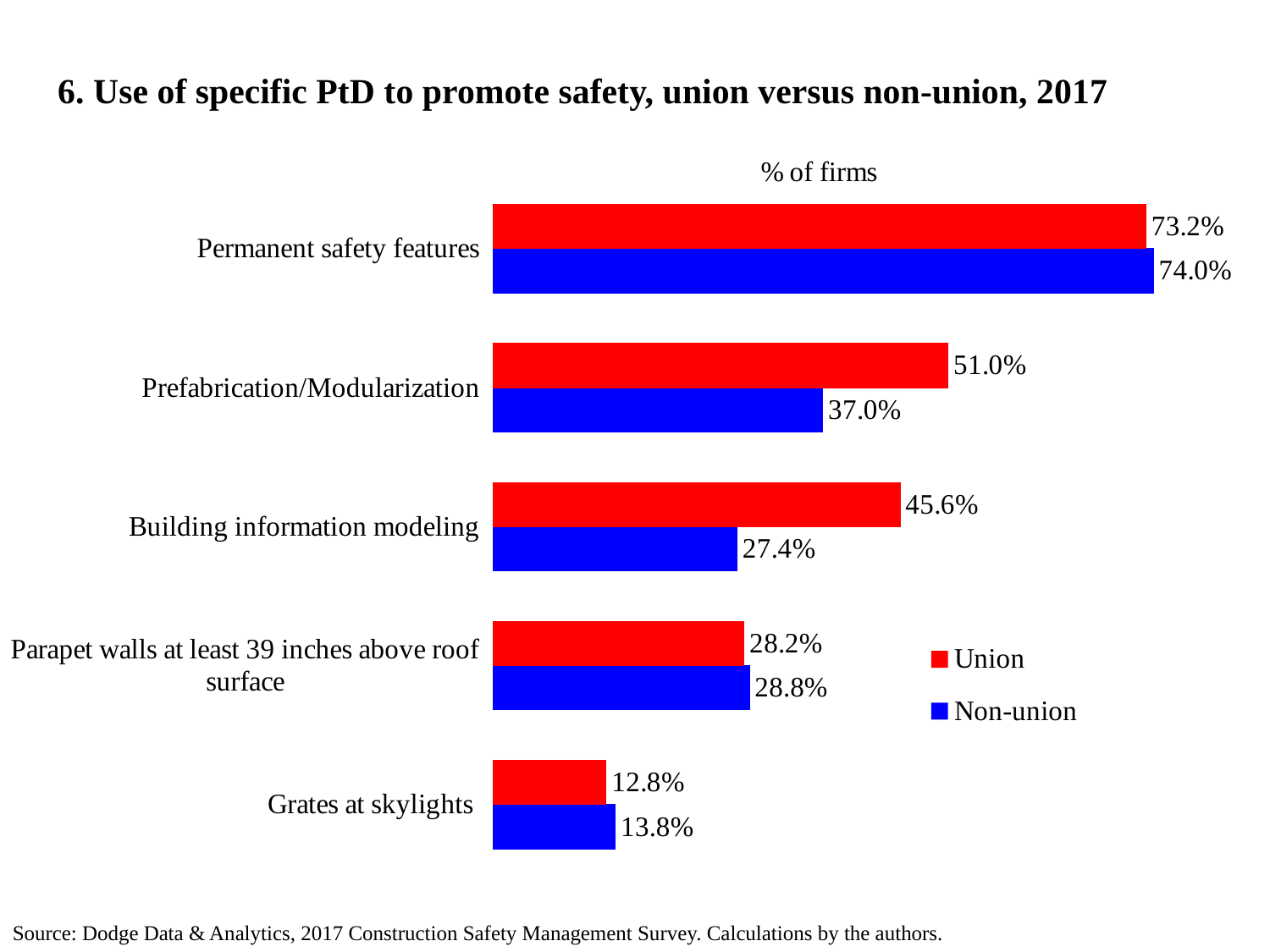
Which colour represents union firms in the chart? Red Which PtD category has the lowest value for non-union firms? Grates at skylights What percentage of non-union firms use prefabrication/modularization? 37.0% What is the difference between union and non-union firms for building information modeling? 18.2 percentage points Which PtD category has the highest value for union firms? Permanent safety features What type of chart is shown on the slide? Bar chart What percentage of union firms use permanent safety features? 73.2% What is the difference between union and non-union firms for prefabrication/modularization? 14.0 percentage points What is the value for non-union firms for building information modeling? 27.4% How many series does the legend list? 2 For grates at skylights, which group has the larger value, union or non-union? Non-union How many PtD categories are shown in the chart? 5